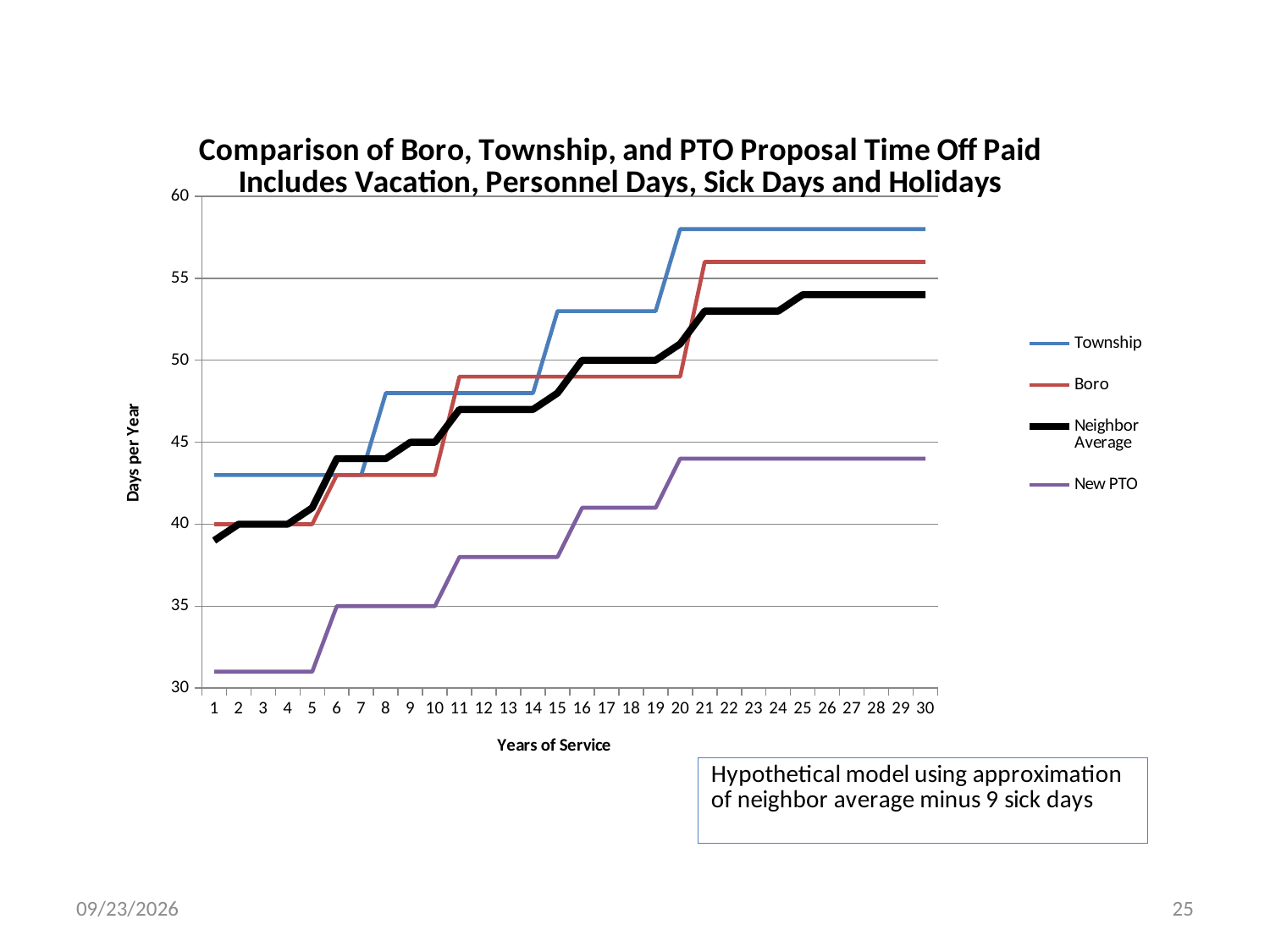
Is the New PTO value at year 1 greater or less than 35? less Do the values for each series generally rise or fall as years of service increase? rise How many series does the legend list? 4 What is the title of the y axis? Days per Year What kind of chart is shown on the slide? line chart At year 30, which is larger, the Boro value or the Township value? Township Is the New PTO value at year 30 greater or less than 45? less What is the New PTO value (days per year) at year 8? 35 Which series has the highest value at year 30? Township Which series has the lowest value at year 30? New PTO Is the Township value at year 30 greater or less than 55? greater How many years of service are shown along the x axis? 30